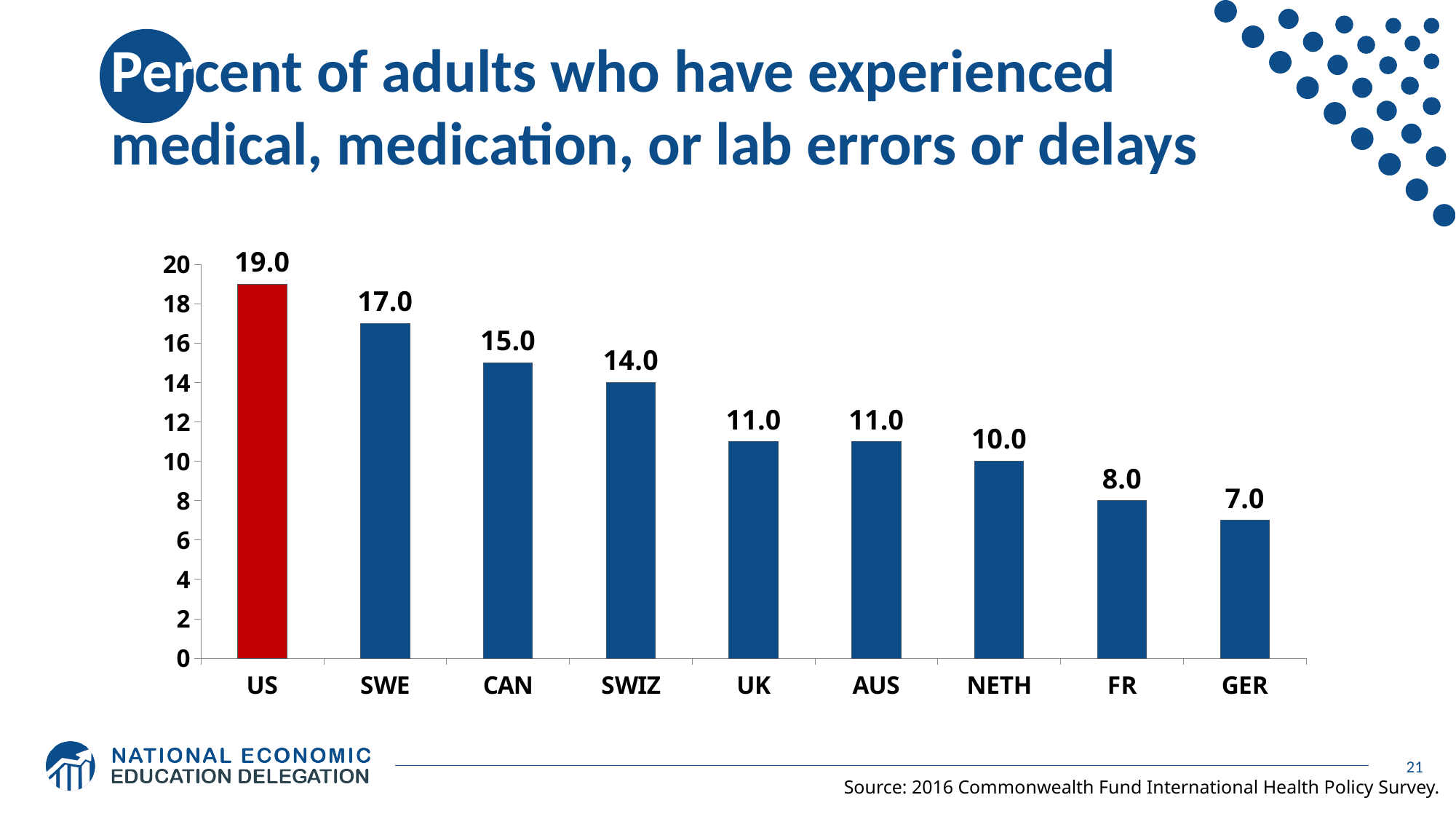
Do the values rise or fall from left to right along the x axis? Fall What is the value for SWIZ? 14.0 What is the difference between the values for the US and SWE? 2.0 What is the value for the US? 19.0 Which is larger, the value for FR or the value for NETH? NETH Which country has the highest value? US Which country has the lowest value? GER What is the value for NETH? 10.0 What kind of chart is shown on the slide? Bar chart How many countries are shown on the chart? 9 Which bar is coloured red? US What is the difference between the values for CAN and GER? 8.0